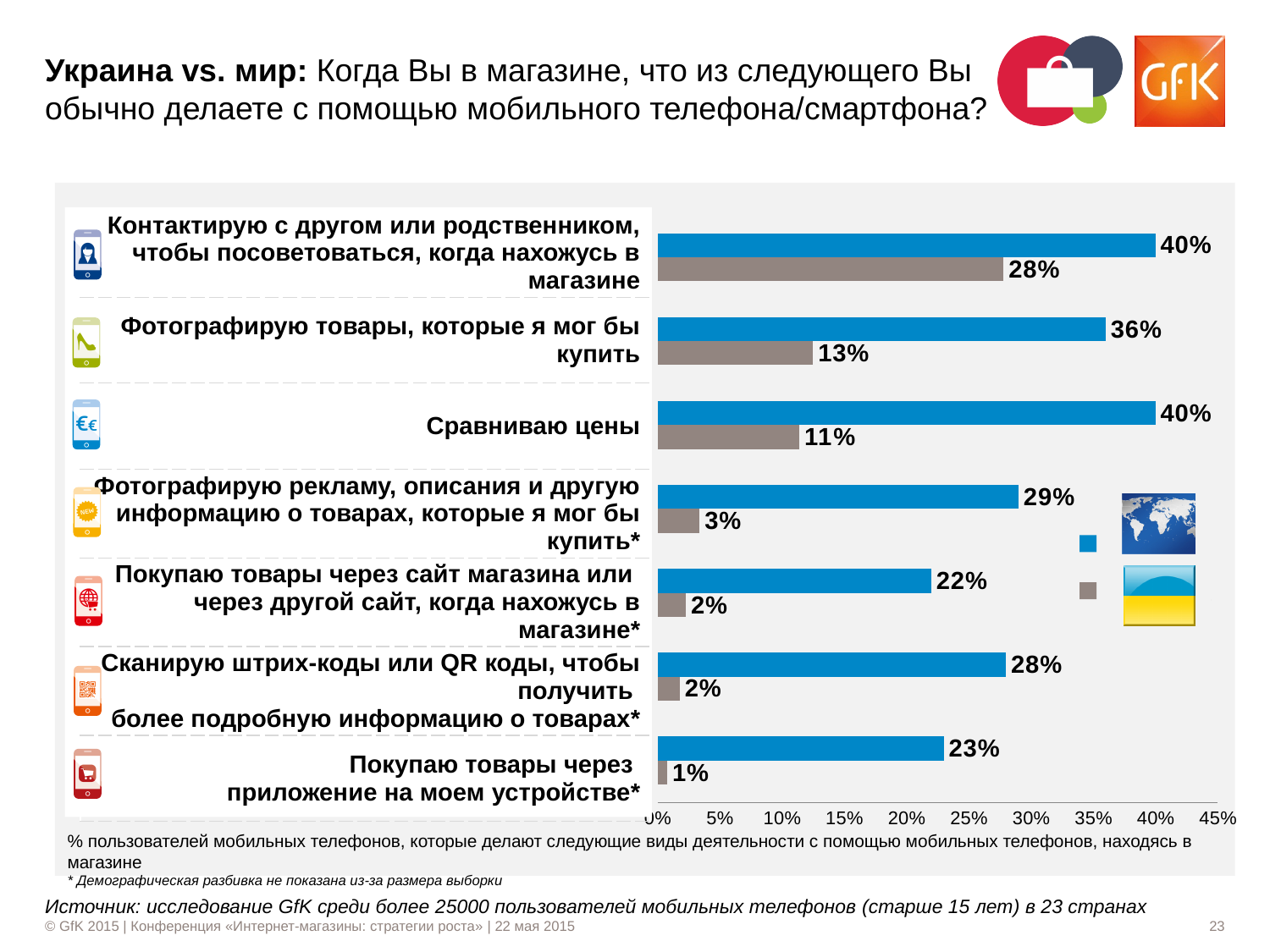
What is the value of the blue bar for "Сравниваю цены"? 40% How many categories are shown in the chart? 7 How many series does the chart show? 2 What is the value of the grey bar for "Фотографирую товары, которые я мог бы купить"? 13% Which category has the highest grey bar value? Контактирую с другом или родственником, чтобы посоветоваться, когда нахожусь в магазине Which category has the lowest grey bar value? Покупаю товары через приложение на моем устройстве* Which is larger: the blue bar for "Фотографирую товары, которые я мог бы купить" or the blue bar for "Фотографирую рекламу, описания и другую информацию о товарах"? Фотографирую товары, которые я мог бы купить What is the value of the grey bar for "Покупаю товары через приложение на моем устройстве*"? 1% What is the difference between the blue and grey bars for "Сканирую штрих-коды или QR коды"? 26% What type of chart is shown on the slide? Bar chart What is the difference between the blue and grey bars for "Сравниваю цены"? 29% Which category has the lowest blue bar value? Покупаю товары через сайт магазина или через другой сайт, когда нахожусь в магазине*